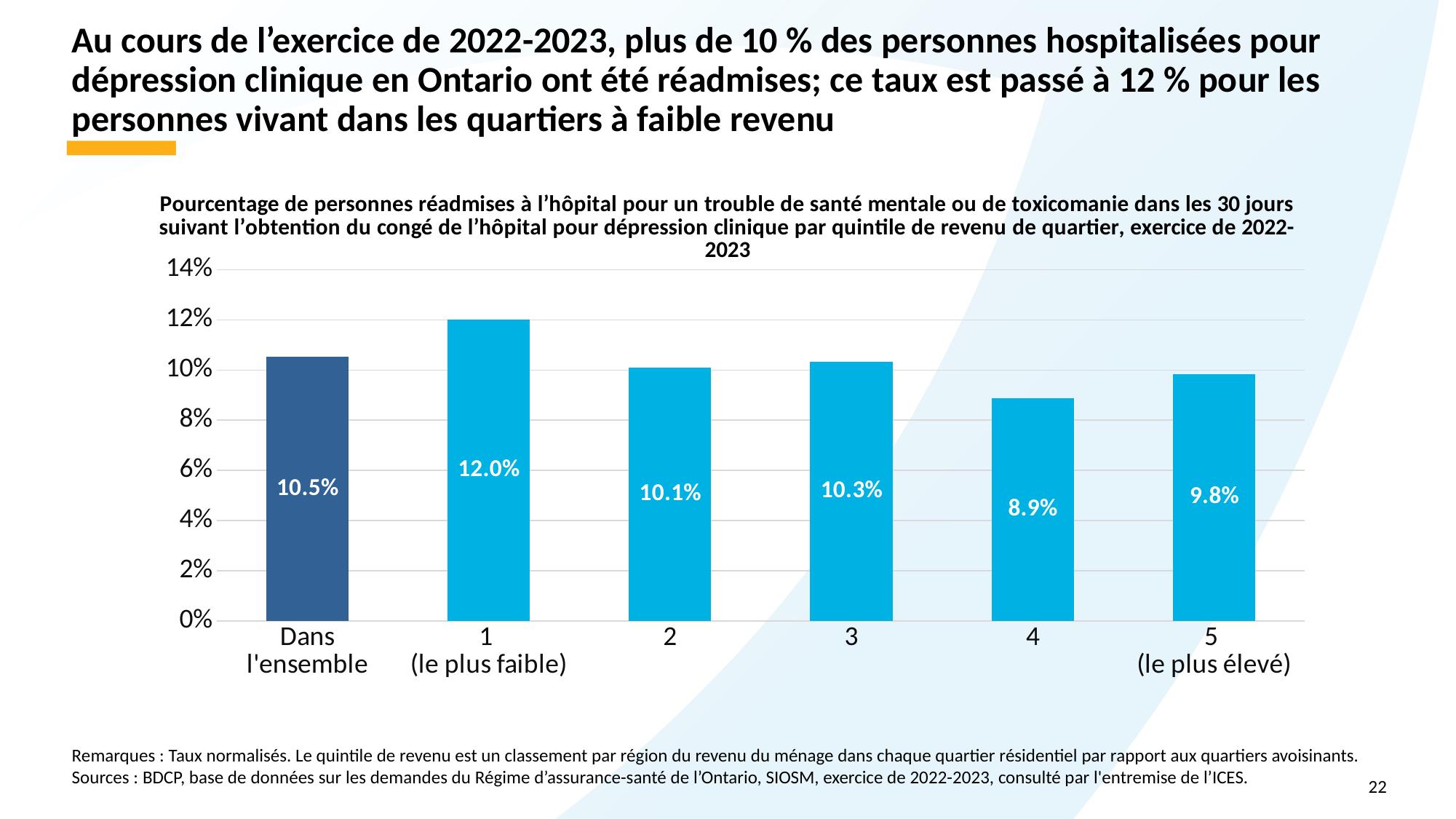
What is the value for quintile 5 (le plus élevé)? 9.8% What is the value for quintile 1 (le plus faible)? 12.0% What is the value for 'Dans l'ensemble'? 10.5% Which category has the highest value? 1 (le plus faible) How many bars are shown in the chart? 6 Which is larger, the value for quintile 2 or the value for quintile 3? 3 Is the value for quintile 4 greater or less than 10%? less Which category has the lowest value? 4 What is the value for quintile 4? 8.9% Which bar is shown in a darker blue colour than the others? Dans l'ensemble What is the difference between quintile 1 (le plus faible) and quintile 5 (le plus élevé)? 2.2% What kind of chart is shown on the slide? Bar chart